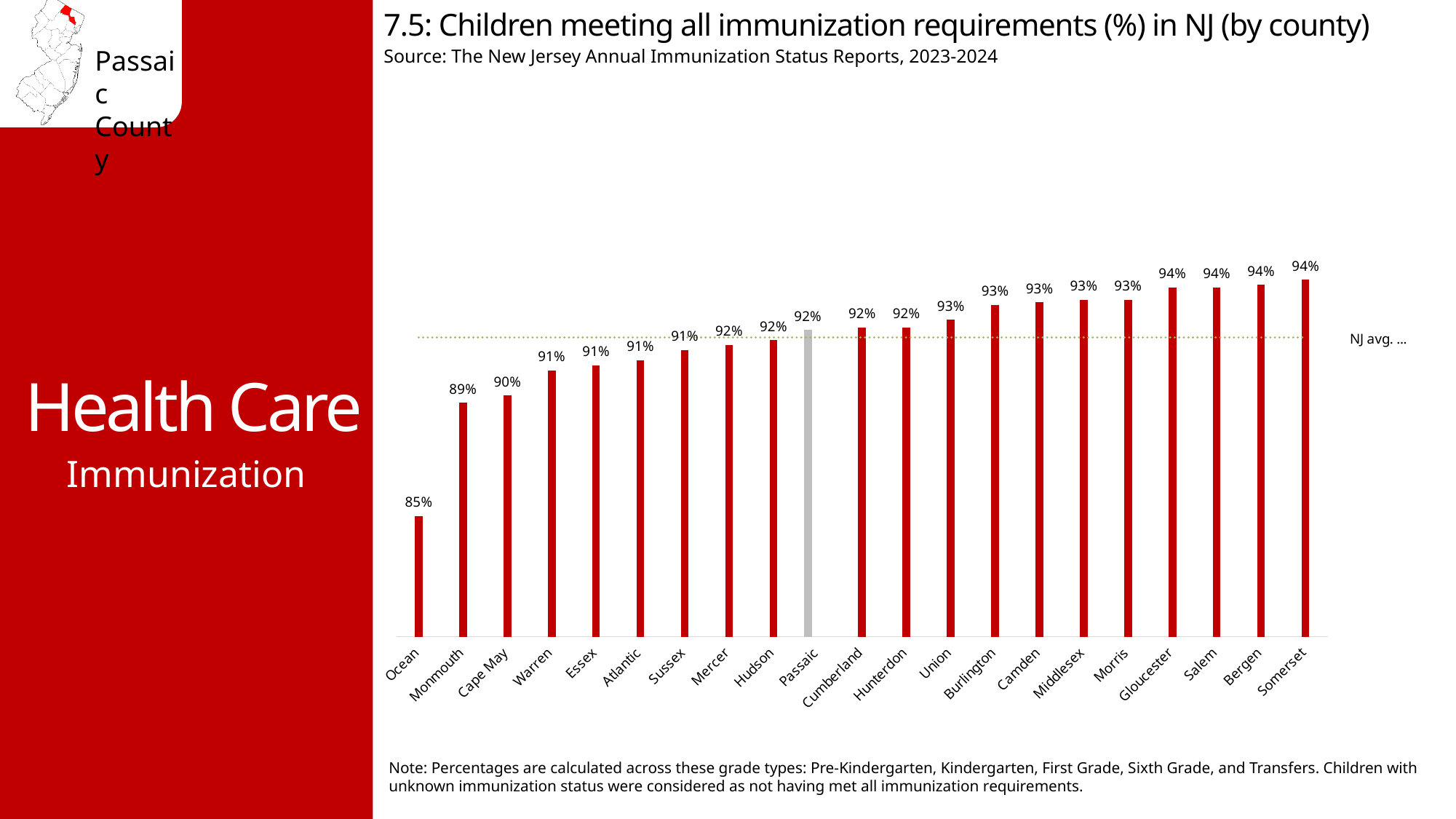
What is the value for Somerset County? 94% What is the value shown for Ocean County? 85% What percentage is shown for Monmouth County? 89% What is the difference in percentage points between Somerset and Ocean? 9 percentage points What is the difference between Monmouth's value and Ocean's value? 4 percentage points How many counties are shown on the chart? 21 Which county has the lowest percentage of children meeting all immunization requirements? Ocean Which has a higher value, Cape May or Union? Union What percentage of children in Passaic County met all immunization requirements? 92% Which county's bar is coloured grey instead of red? Passaic What type of chart is used on this slide? Bar chart Do the values rise or fall moving from left to right along the x axis? Rise